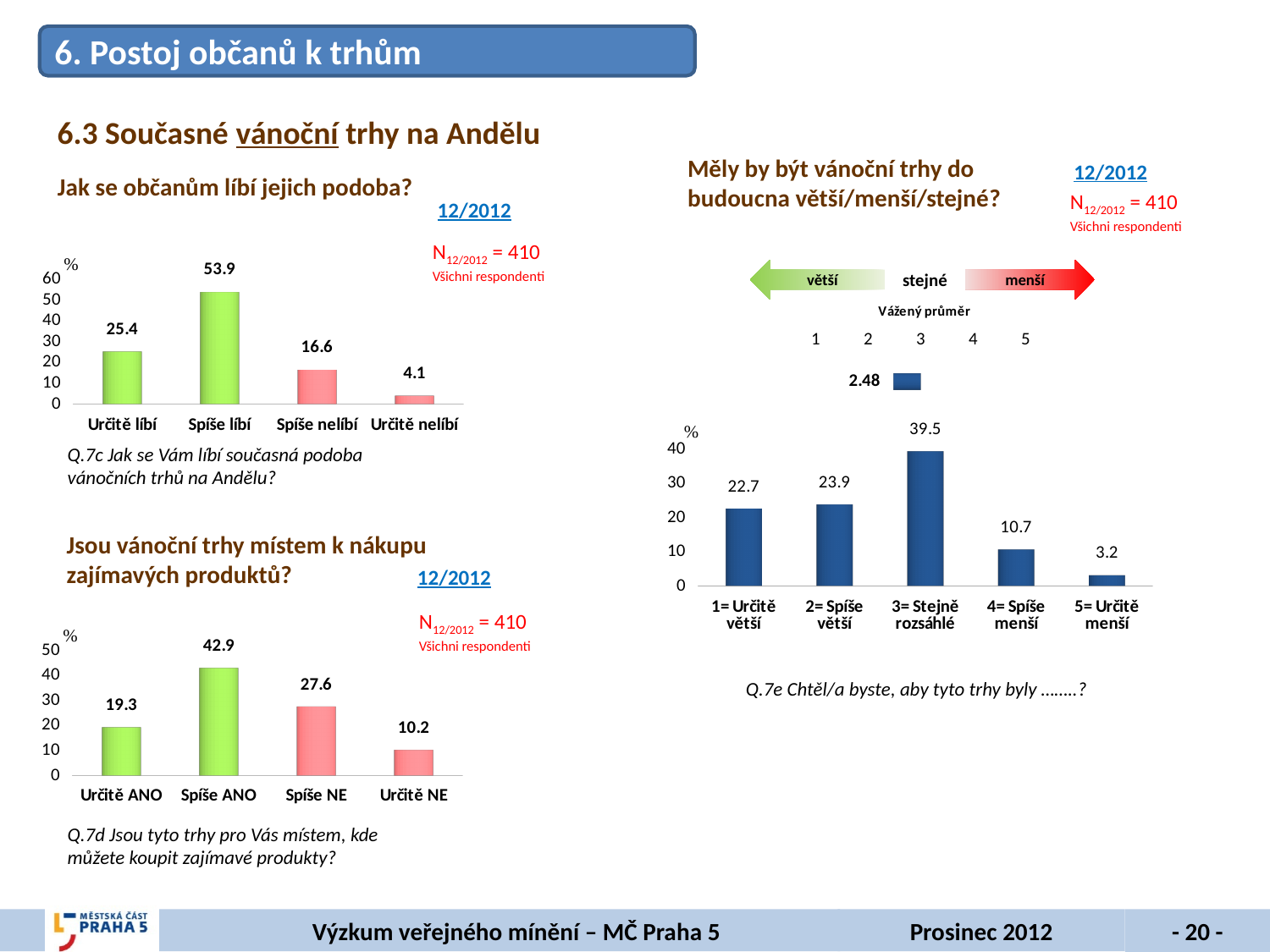
In the chart 'Měly by být vánoční trhy do budoucna větší/menší/stejné?', how many categories are shown? 5 In the chart 'Jak se občanům líbí jejich podoba?', which category has the lowest value? Určitě nelíbí In the chart 'Jak se občanům líbí jejich podoba?', what is the value for 'Spíše líbí'? 53.9 In the chart 'Měly by být vánoční trhy do budoucna větší/menší/stejné?', which category has the lowest value? 5= Určitě menší In the chart 'Jsou vánoční trhy místem k nákupu zajímavých produktů?', how many categories are shown? 4 What type of chart is used for 'Jak se občanům líbí jejich podoba?'? Bar chart In the chart 'Jsou vánoční trhy místem k nákupu zajímavých produktů?', what is the value for 'Spíše NE'? 27.6 In the chart 'Měly by být vánoční trhy do budoucna větší/menší/stejné?', what is the value for '3= Stejně rozsáhlé'? 39.5 In the chart 'Jsou vánoční trhy místem k nákupu zajímavých produktů?', which is larger: 'Určitě ANO' or 'Určitě NE'? Určitě ANO In the chart 'Měly by být vánoční trhy do budoucna větší/menší/stejné?', what is the weighted average (Vážený průměr) shown? 2.48 In the chart 'Jak se občanům líbí jejich podoba?', what is the difference between 'Spíše líbí' and 'Určitě líbí'? 28.5 In the chart 'Jsou vánoční trhy místem k nákupu zajímavých produktů?', which category has the highest value? Spíše ANO